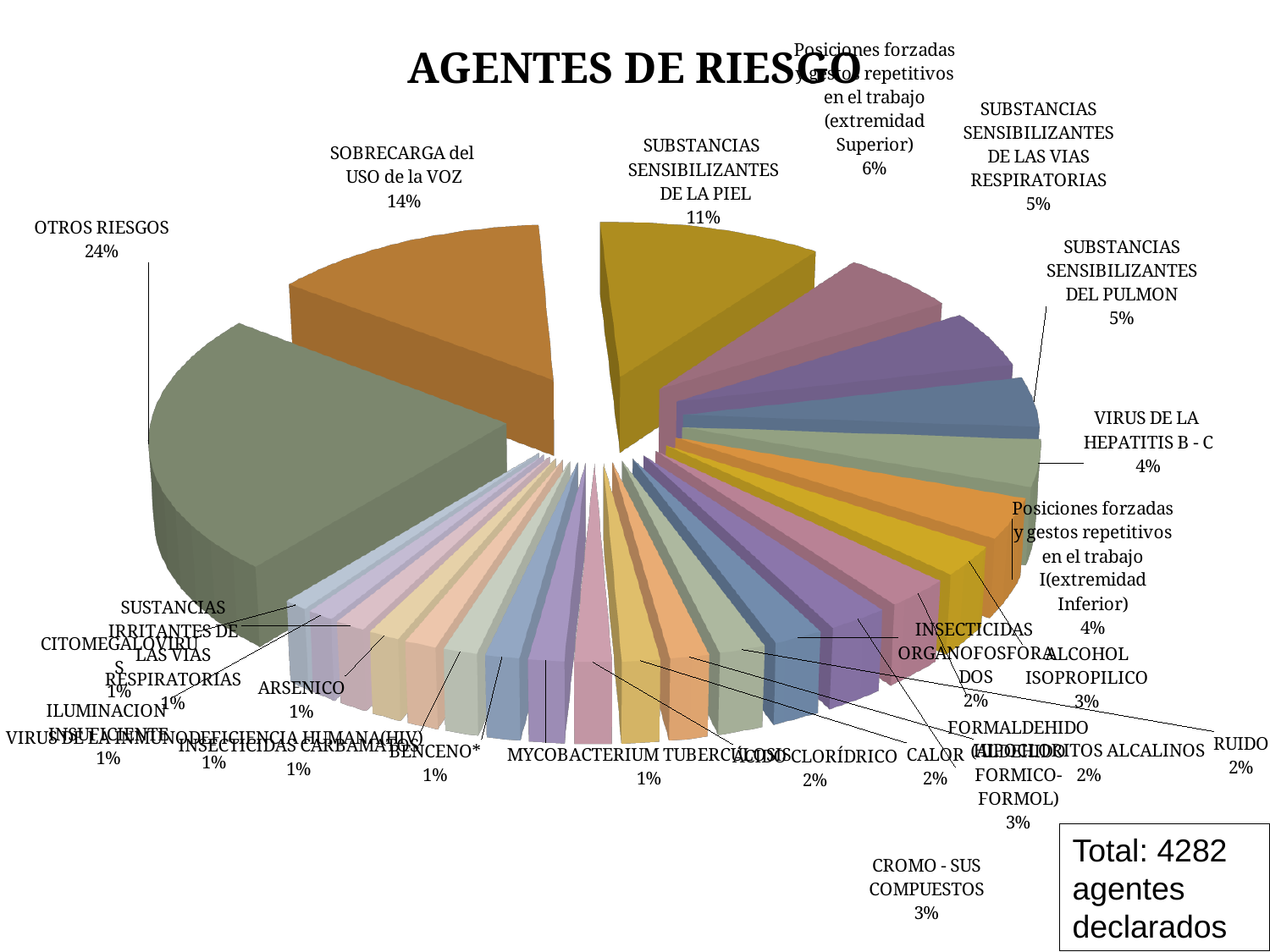
What percentage is shown for SOBRECARGA del USO de la VOZ? 14% What share of the pie does OTROS RIESGOS represent? 24% According to the text box on the slide, how many agentes declarados are there in total? 4282 What is the title of the chart? AGENTES DE RIESGO What is the difference in percentage points between OTROS RIESGOS and SOBRECARGA del USO de la VOZ? 10 What percentage is shown for RUIDO? 2% Which category has the largest share of the pie? OTROS RIESGOS What kind of chart is shown on the slide? pie chart What percentage is shown for SUBSTANCIAS SENSIBILIZANTES DE LA PIEL? 11% What percentage is shown for CROMO - SUS COMPUESTOS? 3% Which is larger, the share for SUBSTANCIAS SENSIBILIZANTES DE LA PIEL or the share for Posiciones forzadas y gestos repetitivos en el trabajo (extremidad Superior)? SUBSTANCIAS SENSIBILIZANTES DE LA PIEL What percentage is shown for VIRUS DE LA HEPATITIS B - C? 4%